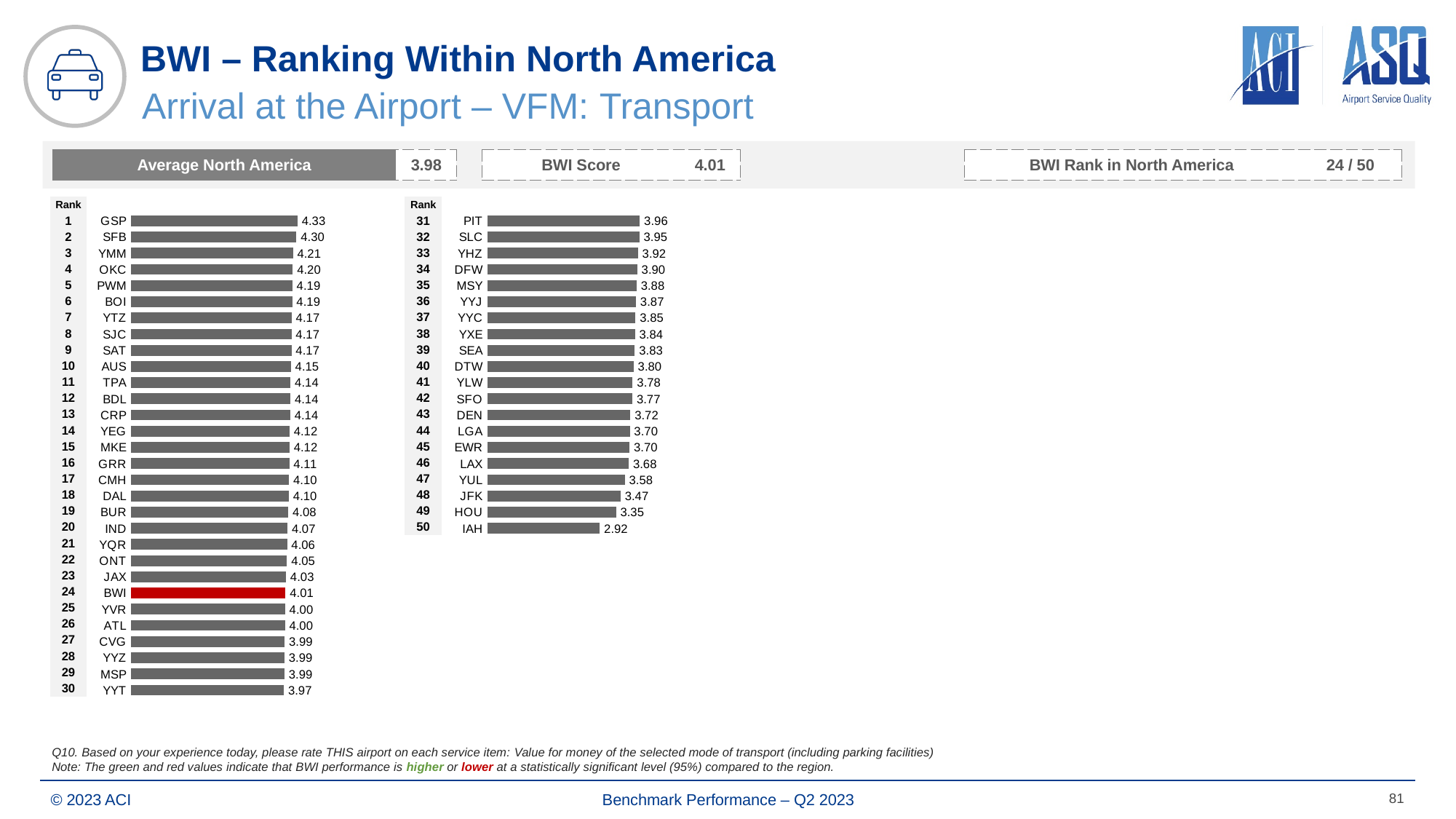
In the left chart (ranks 1-30), which airport has the highest value? GSP How many airports are plotted in the right chart (ranks 31-50)? 20 What kind of chart is used to show the airport rankings on this slide? Bar chart How many airports are plotted in the left chart (ranks 1-30)? 30 In the right chart (ranks 31-50), do the values rise or fall going down from rank 31 to rank 50? Fall In the right chart (ranks 31-50), which is larger, the value for LAX or the value for HOU? LAX In the left chart (ranks 1-30), which bar is coloured red? BWI In the right chart (ranks 31-50), what is the value for JFK? 3.47 What is the difference between the values for GSP and BWI in the left chart (ranks 1-30)? 0.32 In the left chart (ranks 1-30), what is the value for BWI? 4.01 In the right chart (ranks 31-50), which airport has the lowest value? IAH In the left chart (ranks 1-30), what is the value for GSP? 4.33